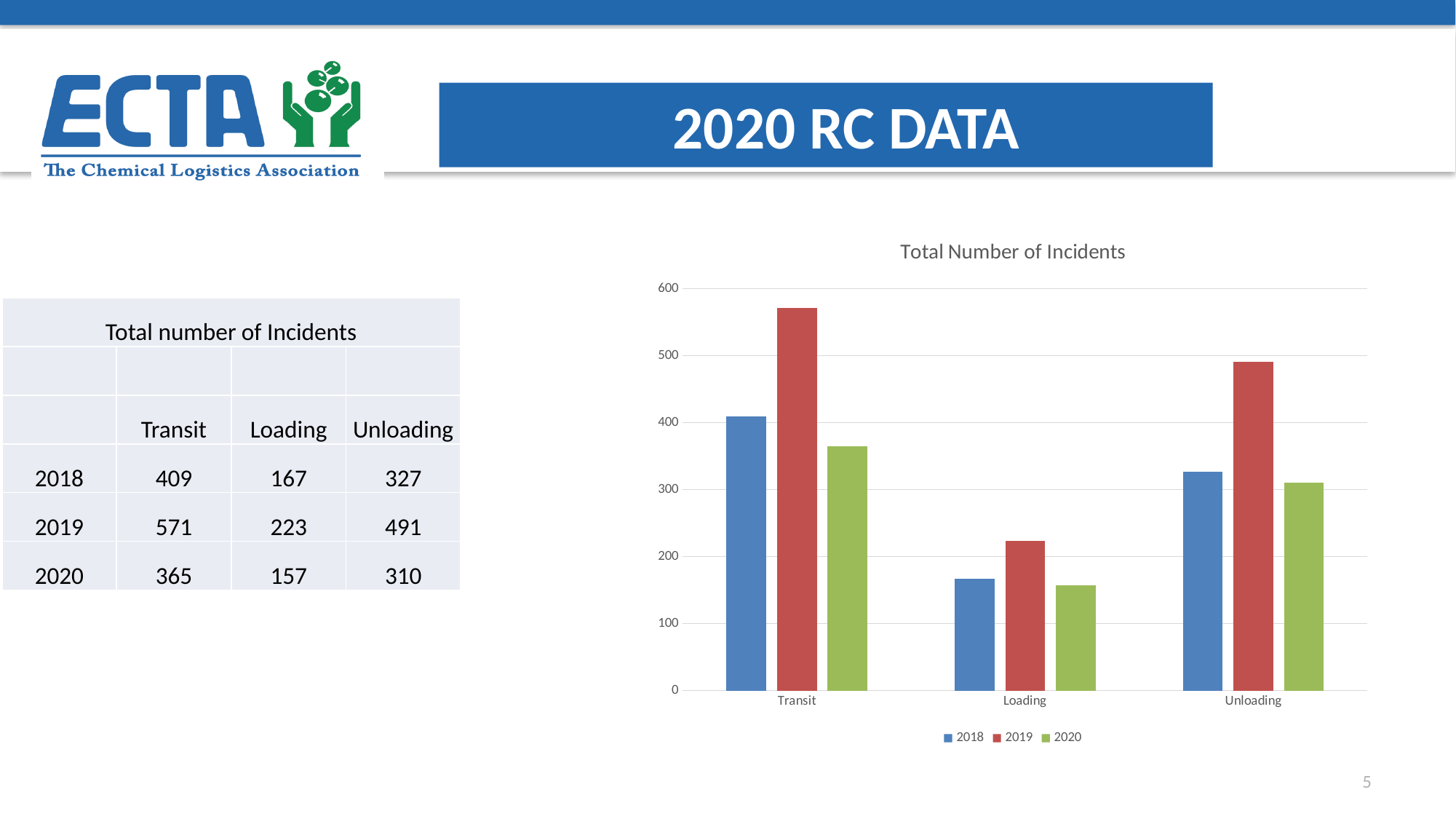
Is the 2019 Transit bar greater or less than 500? greater Which category has the highest number of incidents for 2018? Transit Which is larger, the 2018 Unloading value or the 2020 Transit value? 2020 Transit What is the title of the chart? Total Number of Incidents Which category has the lowest number of incidents for 2019? Loading Which colour represents the 2020 series in the chart? green What is the number of Transit incidents for 2019? 571 How many series does the chart legend list? 3 What kind of chart is shown on the slide? bar chart What is the number of Loading incidents for 2020? 157 What is the difference between the 2019 and 2020 Unloading incidents? 181 How many categories are shown on the x axis of the chart? 3